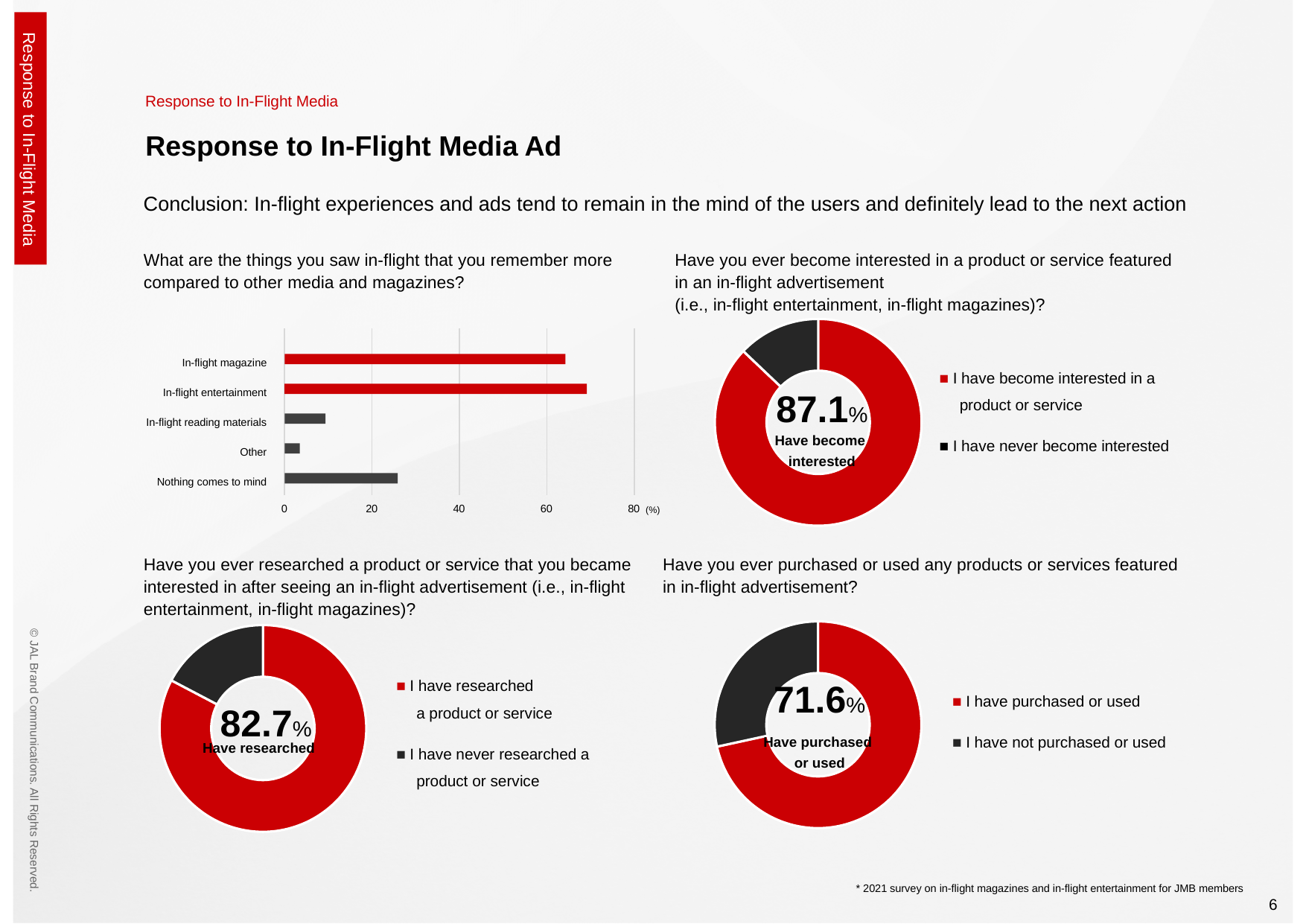
What kind of chart is used for the question about things remembered in-flight compared to other media? Bar chart In the bar chart at the top left, is the value for In-flight magazine greater or less than 60? greater How many entries does the legend of the 'Have you ever purchased or used' donut chart list? 2 In the donut chart for 'Have you ever become interested in a product or service featured in an in-flight advertisement', what share have become interested? 87.1% In the 'Have you ever researched' donut chart, what colour is the 'I have researched a product or service' segment? Red In the donut chart for 'Have you ever purchased or used any products or services', what share have purchased or used? 71.6% In the bar chart at the top left, which category has the lowest value? Other In the bar chart at the top left, how many categories are shown? 5 In the donut chart for 'Have you ever researched a product or service', what share have researched a product or service? 82.7% In the bar chart at the top left, which category has the highest value? In-flight entertainment In the bar chart at the top left, is the value for Nothing comes to mind greater or less than 40? less In the bar chart at the top left, which is larger: the value for In-flight reading materials or the value for Nothing comes to mind? Nothing comes to mind